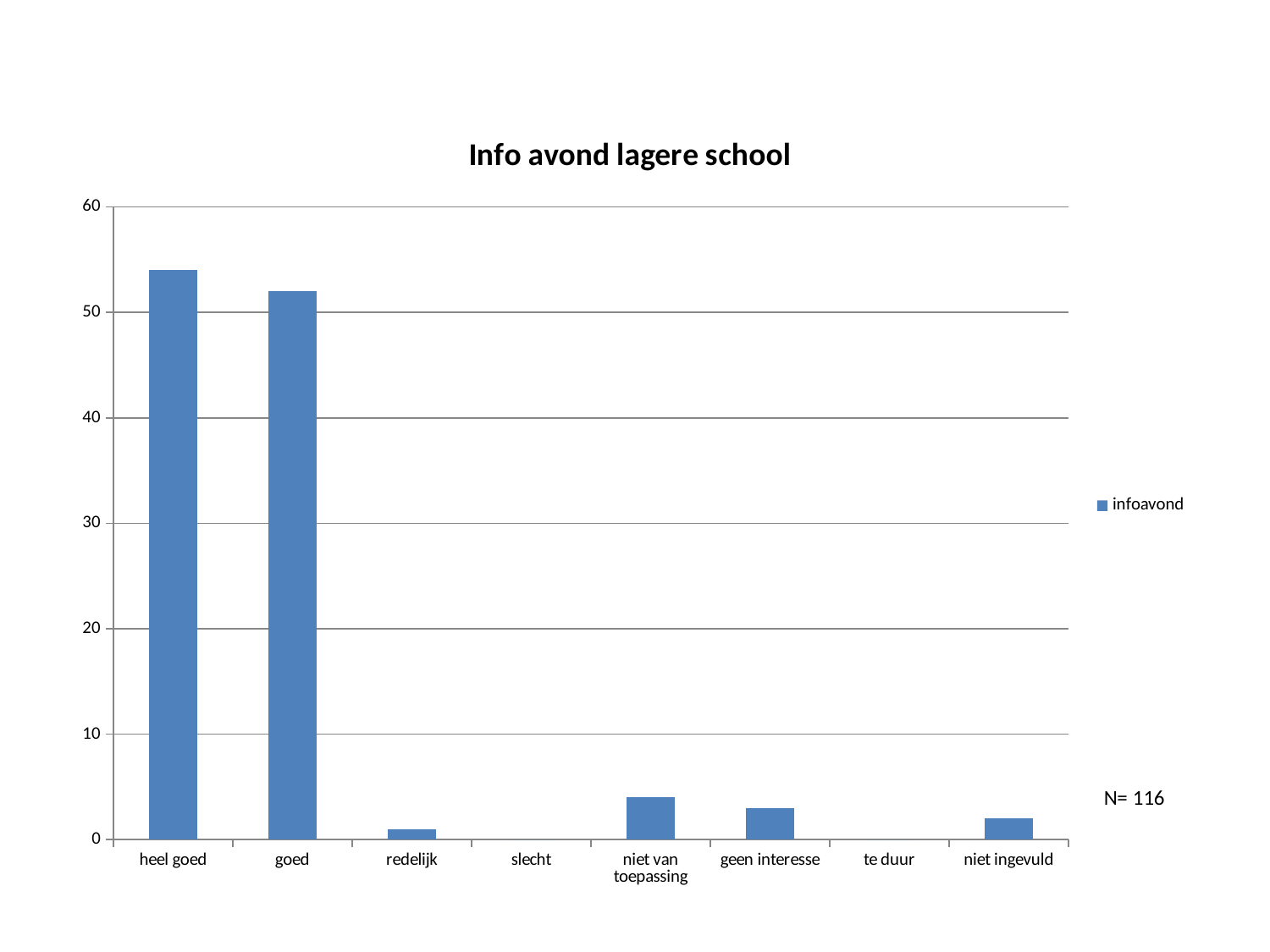
What kind of chart is shown on the slide? bar chart Which is larger, the value for goed or the value for niet ingevuld? goed Is the value for niet van toepassing greater or less than 10? less Which is larger, the value for heel goed or the value for goed? heel goed Is the value for heel goed greater or less than 50? greater How many categories are shown on the x axis of the chart? 8 How many series does the legend list? 1 Is the value for goed greater or less than 50? greater What is the name of the series shown in the legend? infoavond Which category has the highest value? heel goed What is the title of the chart? Info avond lagere school